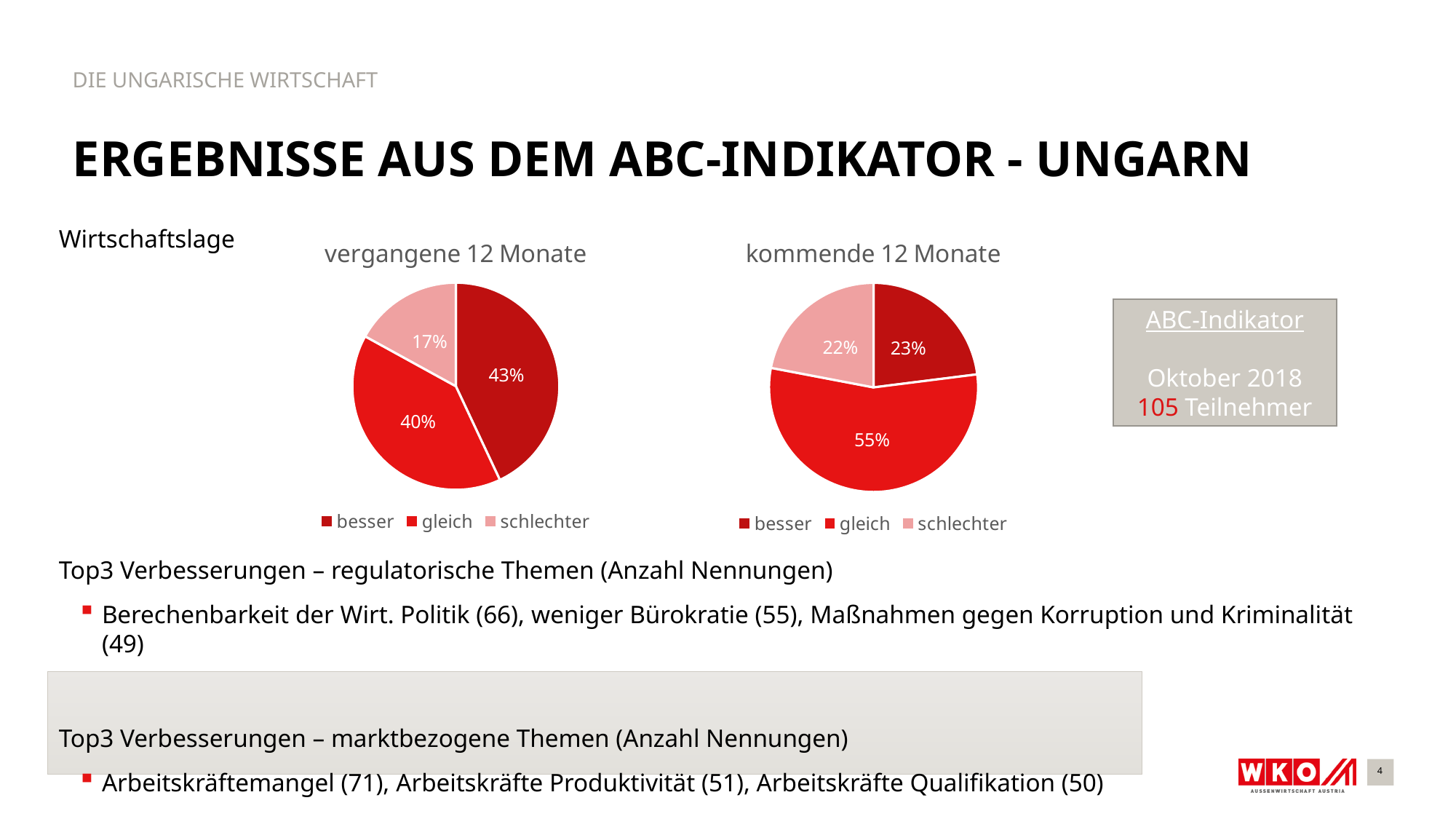
In the 'vergangene 12 Monate' pie chart, what share is labelled 'schlechter'? 17% What are the legend entries of the 'kommende 12 Monate' pie chart? besser, gleich, schlechter In the 'kommende 12 Monate' pie chart, what is the difference between the 'gleich' and 'schlechter' shares? 33% What kind of chart is used for 'kommende 12 Monate'? pie chart Which is larger: the 'schlechter' share in the 'vergangene 12 Monate' chart or the 'schlechter' share in the 'kommende 12 Monate' chart? kommende 12 Monate In the 'vergangene 12 Monate' pie chart, what is the difference between the 'besser' and 'gleich' shares? 3% How many categories does the legend of the 'vergangene 12 Monate' pie chart list? 3 In the 'kommende 12 Monate' pie chart, what share is labelled 'besser'? 23% In the 'vergangene 12 Monate' pie chart, which category has the largest slice? besser In the 'kommende 12 Monate' pie chart, which category has the smallest slice? schlechter In the 'kommende 12 Monate' pie chart, what share is labelled 'gleich'? 55% In the 'vergangene 12 Monate' pie chart, what share is labelled 'besser'? 43%